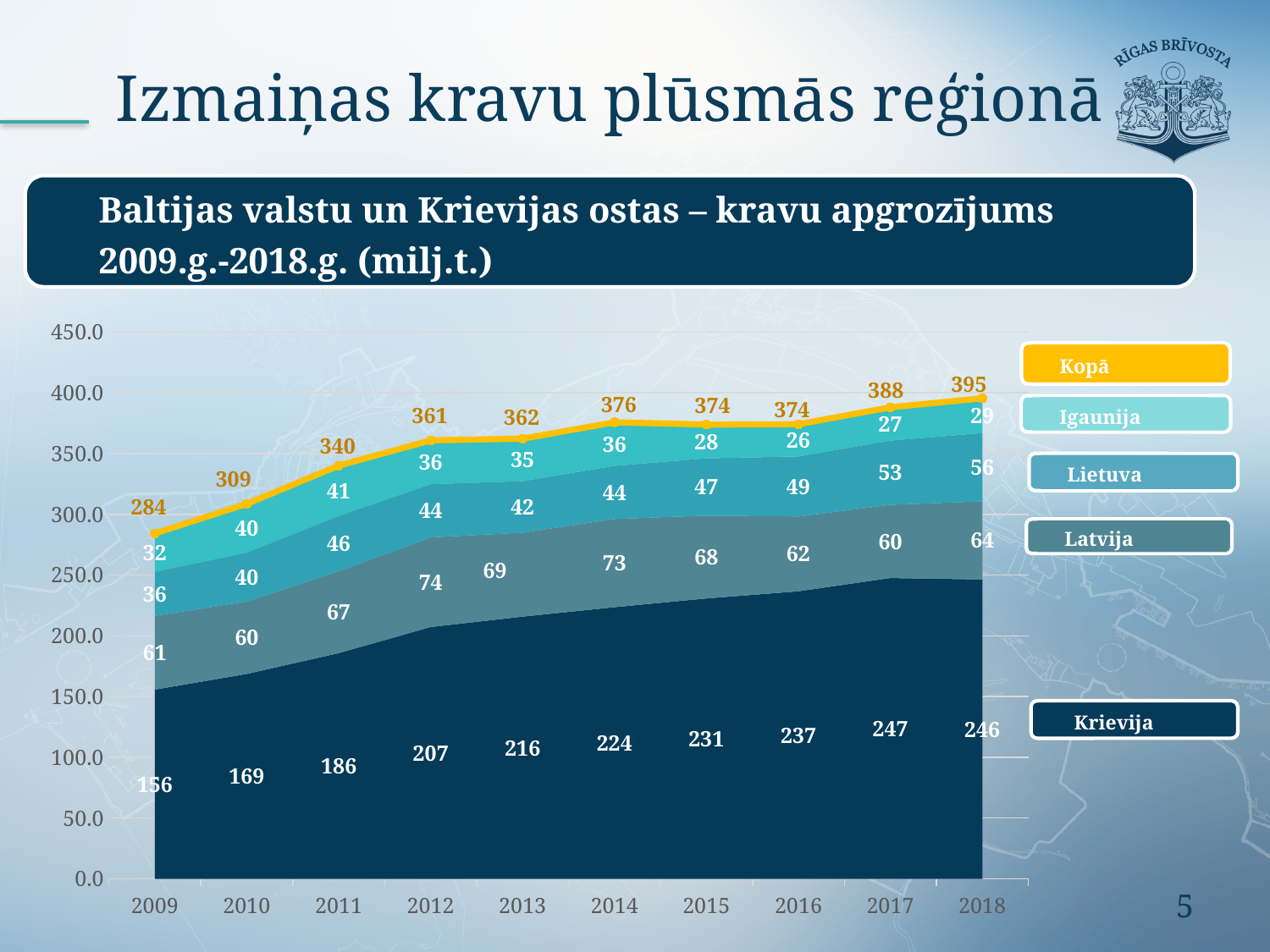
Which series is drawn as a yellow line on the chart? Kopā Which is larger, the Lietuva value in 2018 or the Latvija value in 2018? Latvija How many years are shown on the x axis? 10 How many series does the legend list? 5 What is the value for Latvija in 2013? 69 What is the value for Igaunija in 2016? 26 What is the value of Kopā (total) for 2018? 395 Does the Krievija value generally rise or fall from 2009 to 2017? rise In which year is the Kopā (total) value the lowest? 2009 In which year is the Krievija value the highest? 2017 What is the value for Krievija in 2012? 207 What is the difference between the Kopā values for 2018 and 2009? 111